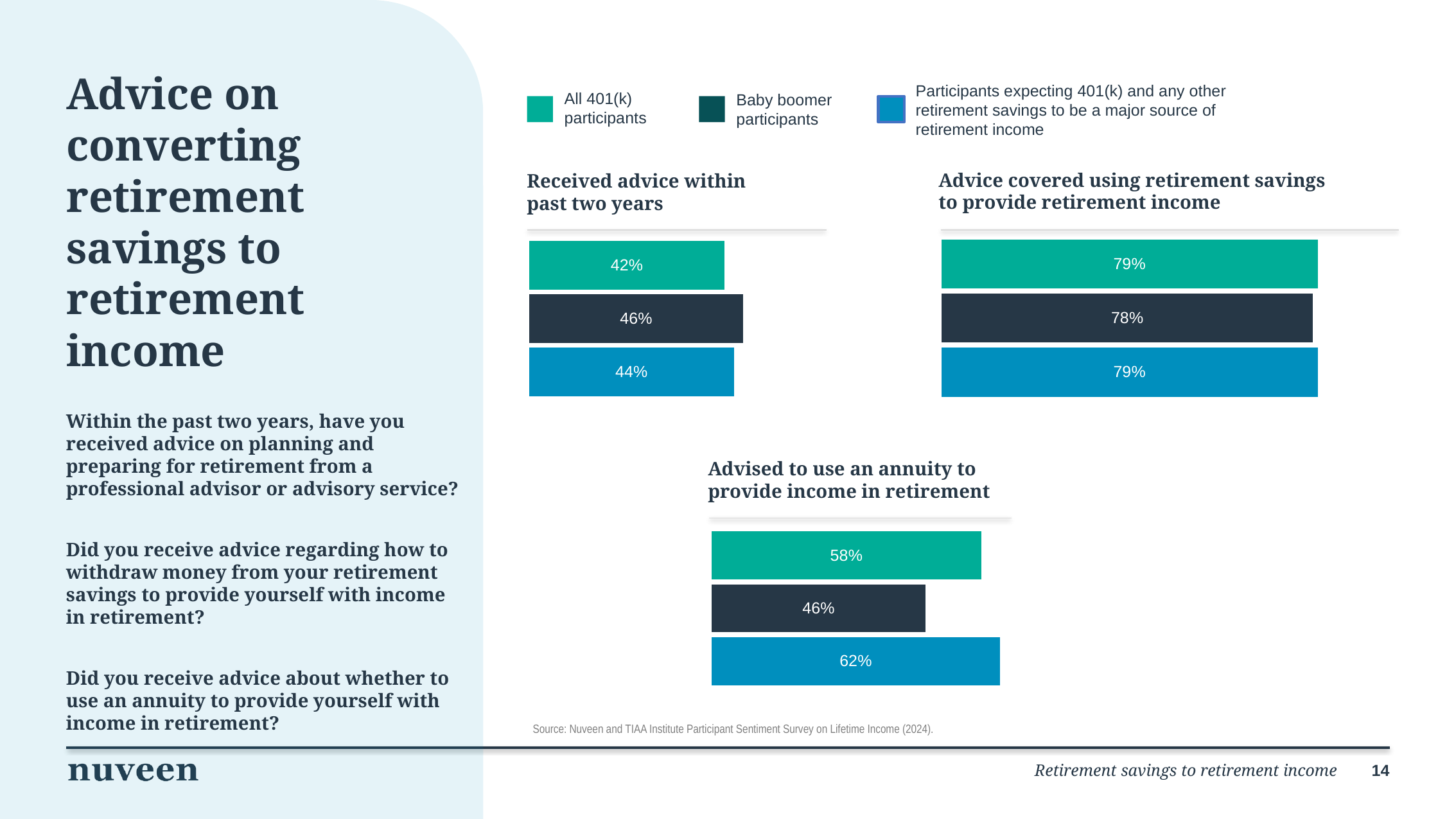
In the 'Received advice within past two years' chart, what is the value for Baby boomer participants? 46% In the 'Received advice within past two years' chart, what is the value for All 401(k) participants? 42% In the 'Advised to use an annuity to provide income in retirement' chart, what is the difference between All 401(k) participants and Baby boomer participants? 12 percentage points How many series does the legend list? 3 In the 'Received advice within past two years' chart, what is the difference between Baby boomer participants and All 401(k) participants? 4 percentage points In the 'Advice covered using retirement savings to provide retirement income' chart, what is the value for Baby boomer participants? 78% In the 'Advised to use an annuity to provide income in retirement' chart, which group has the highest value? Participants expecting 401(k) and any other retirement savings to be a major source of retirement income How many bars are in the 'Advice covered using retirement savings to provide retirement income' chart? 3 In the 'Advised to use an annuity to provide income in retirement' chart, which group has the lowest value? Baby boomer participants In the 'Advised to use an annuity to provide income in retirement' chart, what is the value for participants expecting 401(k) and any other retirement savings to be a major source of retirement income? 62% What kind of chart is the 'Received advice within past two years' chart? Bar chart In the 'Advised to use an annuity to provide income in retirement' chart, which is larger: the value for All 401(k) participants or for Baby boomer participants? All 401(k) participants